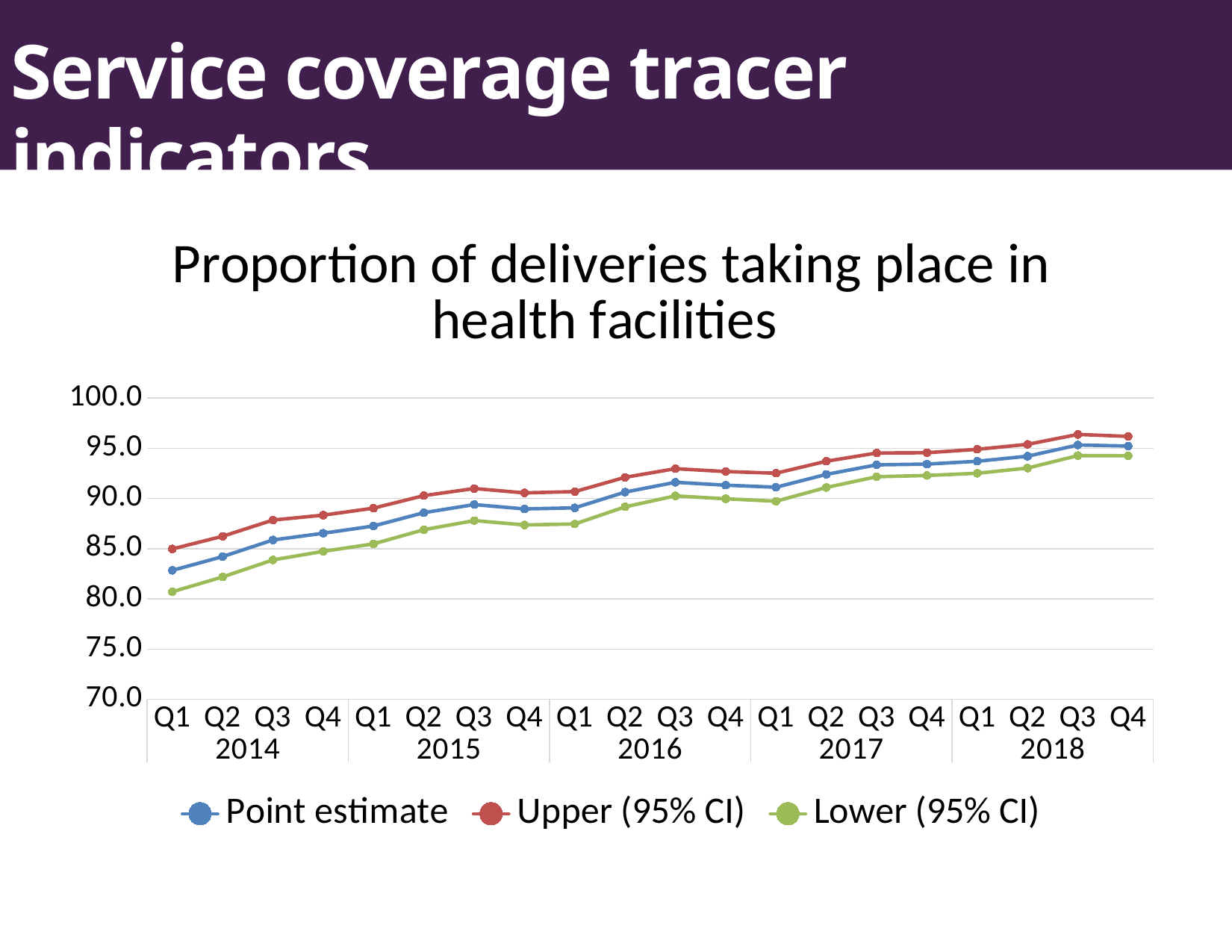
How many series does the legend list? 3 What kind of chart is shown on the slide? Line chart What is the title of the chart? Proportion of deliveries taking place in health facilities Do the Point estimate values generally rise or fall from Q1 2014 to Q4 2018? Rise Is the Lower (95% CI) value for Q3 2014 greater or less than 85? less Which series are listed in the legend? Point estimate, Upper (95% CI), Lower (95% CI) How many quarterly data points are plotted for each series? 20 Is the Point estimate value for Q1 2014 greater or less than 85? less In which quarter is the Point estimate lowest? Q1 2014 Which is larger, the Point estimate for Q1 2014 or for Q4 2018? Q4 2018 Is the Upper (95% CI) value for Q3 2018 greater or less than 95? greater